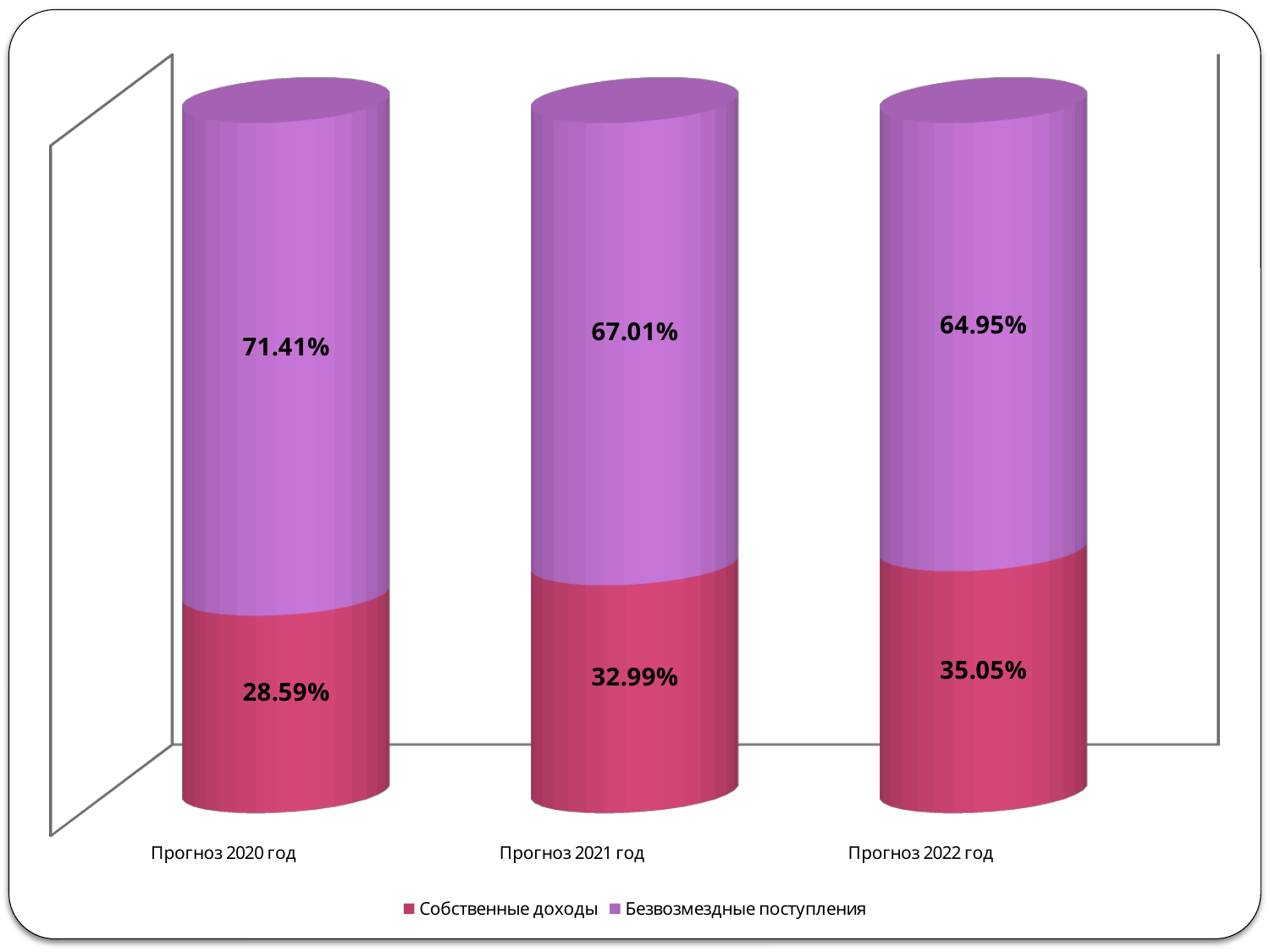
In which category is Безвозмездные поступления highest? Прогноз 2020 год Which is larger for Прогноз 2022 год: Собственные доходы or Безвозмездные поступления? Безвозмездные поступления Does the value of Собственные доходы rise or fall from Прогноз 2020 год to Прогноз 2022 год? Rise What is the value of Безвозмездные поступления for Прогноз 2021 год? 67.01% What is the value of Собственные доходы for Прогноз 2022 год? 35.05% What is the value of Безвозмездные поступления for Прогноз 2022 год? 64.95% How many categories are shown on the x axis? 3 In which category is Собственные доходы lowest? Прогноз 2020 год What is the value of Собственные доходы for Прогноз 2020 год? 28.59% What kind of chart is shown on the slide? Stacked bar chart How many series does the legend list? 2 What is the difference between Безвозмездные поступления and Собственные доходы for Прогноз 2021 год? 34.02%